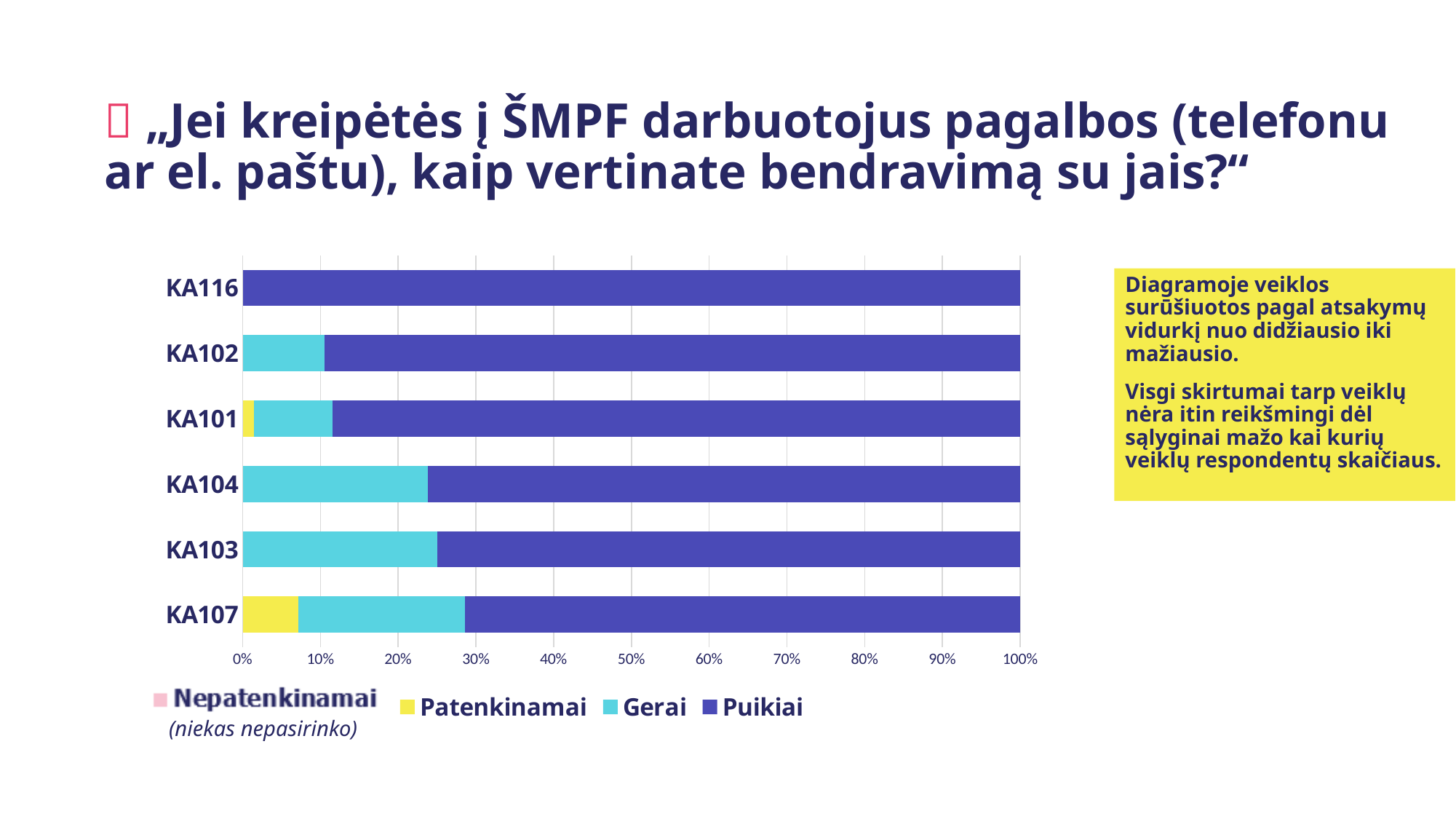
Is the Puikiai share for KA107 greater or less than 80%? less How many activity categories (KA codes) are shown on the chart? 6 Which category has the smallest Puikiai share? KA107 Which category has the largest Patenkinamai share? KA107 Is the Gerai share for KA104 greater or less than 20%? greater Is the Gerai share for KA102 greater or less than 20%? less What is the Puikiai share for KA116? 100% How many series does the chart legend list? 4 Which category has the highest Puikiai share? KA116 Which has a larger Gerai share, KA102 or KA103? KA103 According to the legend note, which response option was chosen by nobody? Nepatenkinamai What kind of chart is shown on the slide? Stacked bar chart